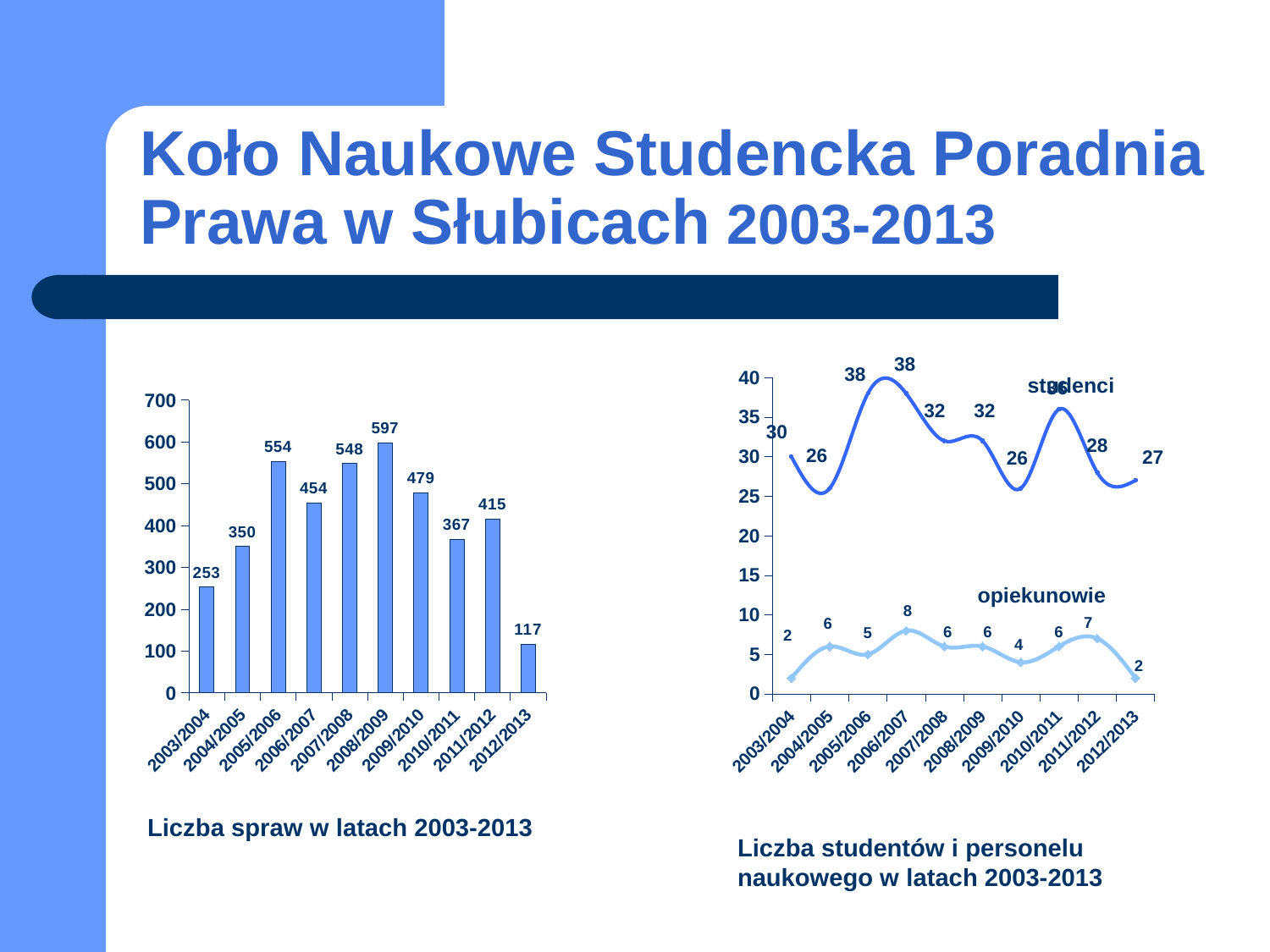
How many bars are in the bar chart 'Liczba spraw w latach 2003-2013'? 10 In the bar chart 'Liczba spraw w latach 2003-2013', is the value for 2004/2005 larger than the value for 2010/2011? No, 2010/2011 (367) is larger than 2004/2005 (350) In the bar chart 'Liczba spraw w latach 2003-2013', what is the difference between the values for 2005/2006 and 2006/2007? 100 In the bar chart 'Liczba spraw w latach 2003-2013', what is the value for 2008/2009? 597 In the bar chart 'Liczba spraw w latach 2003-2013', which year has the lowest value? 2012/2013 In the bar chart 'Liczba spraw w latach 2003-2013', which year has the highest value? 2008/2009 What type of chart is the chart on the left of the slide? Bar chart In the line chart 'Liczba studentów i personelu naukowego w latach 2003-2013', what is the value for studenci in 2005/2006? 38 In the line chart 'Liczba studentów i personelu naukowego w latach 2003-2013', which year has the highest value for opiekunowie? 2006/2007 How many series are plotted in the line chart 'Liczba studentów i personelu naukowego w latach 2003-2013'? 2 In the line chart 'Liczba studentów i personelu naukowego w latach 2003-2013', what is the difference between studenci and opiekunowie in 2012/2013? 25 In the line chart 'Liczba studentów i personelu naukowego w latach 2003-2013', what is the value for opiekunowie in 2006/2007? 8